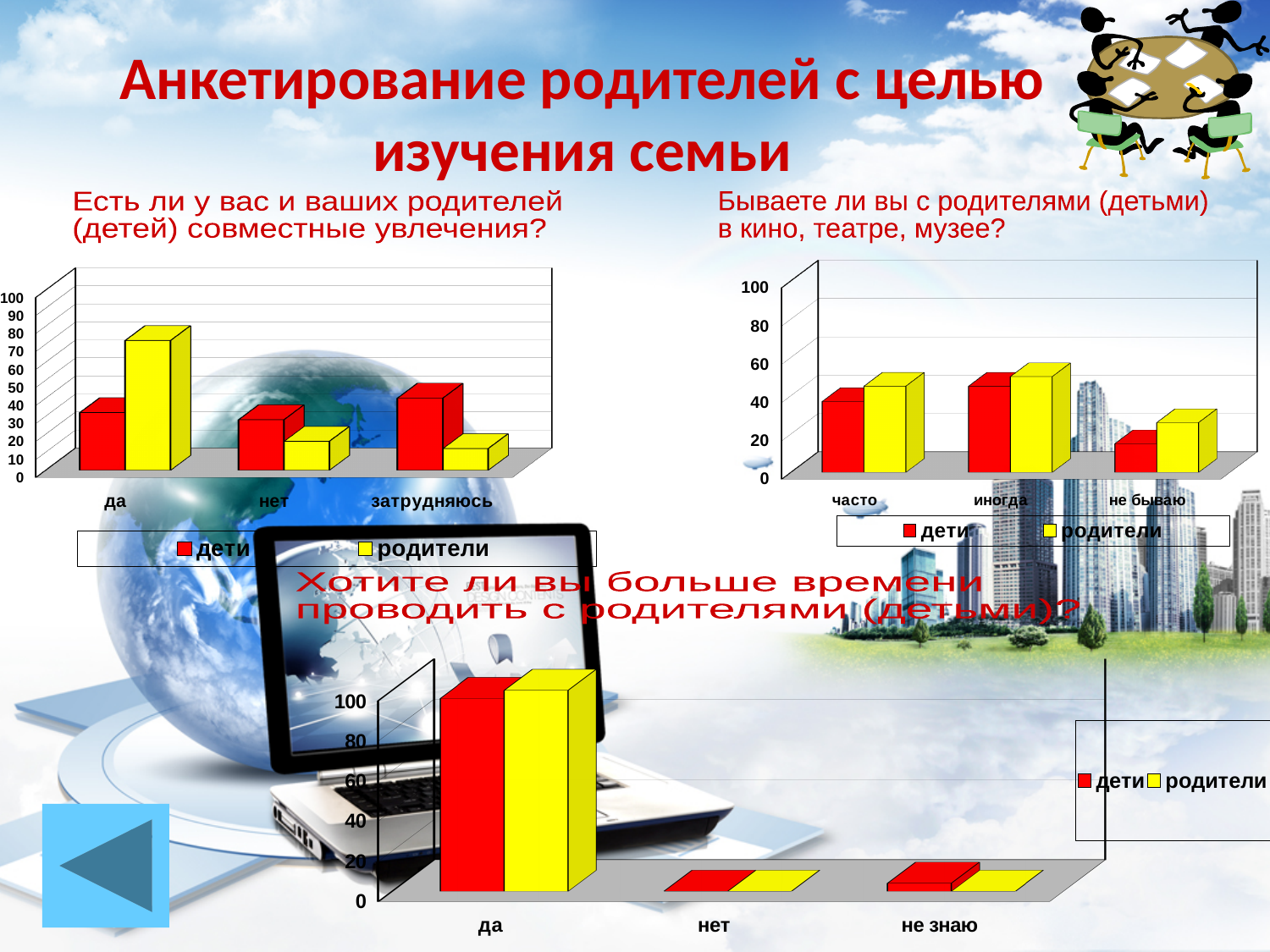
In the chart "Бываете ли вы с родителями (детьми) в кино, театре, музее?", which category has the lowest value for дети? не бываю How many categories are shown on the x axis of the chart "Есть ли у вас и ваших родителей (детей) совместные увлечения?"? 3 In the chart "Есть ли у вас и ваших родителей (детей) совместные увлечения?", which is larger for the category нет: дети or родители? дети In the chart "Есть ли у вас и ваших родителей (детей) совместные увлечения?", which category has the highest value for родители? да In the chart "Есть ли у вас и ваших родителей (детей) совместные увлечения?", is the value for родители in the category да greater or less than 60? greater In the chart "Хотите ли вы больше времени проводить с родителями (детьми)?", which category has the highest value for дети? да What colour represents the series родители in the charts on this slide? yellow In the chart "Бываете ли вы с родителями (детьми) в кино, театре, музее?", is the value for дети in the category не бываю greater or less than 40? less In the chart "Бываете ли вы с родителями (детьми) в кино, театре, музее?", which is larger for the category часто: дети or родители? родители How many series does the legend list for the chart "Бываете ли вы с родителями (детьми) в кино, театре, музее?"? 2 In the chart "Хотите ли вы больше времени проводить с родителями (детьми)?", is the value for родители in the category да greater or less than 80? greater What kind of chart is used for the question "Есть ли у вас и ваших родителей (детей) совместные увлечения?"? bar chart